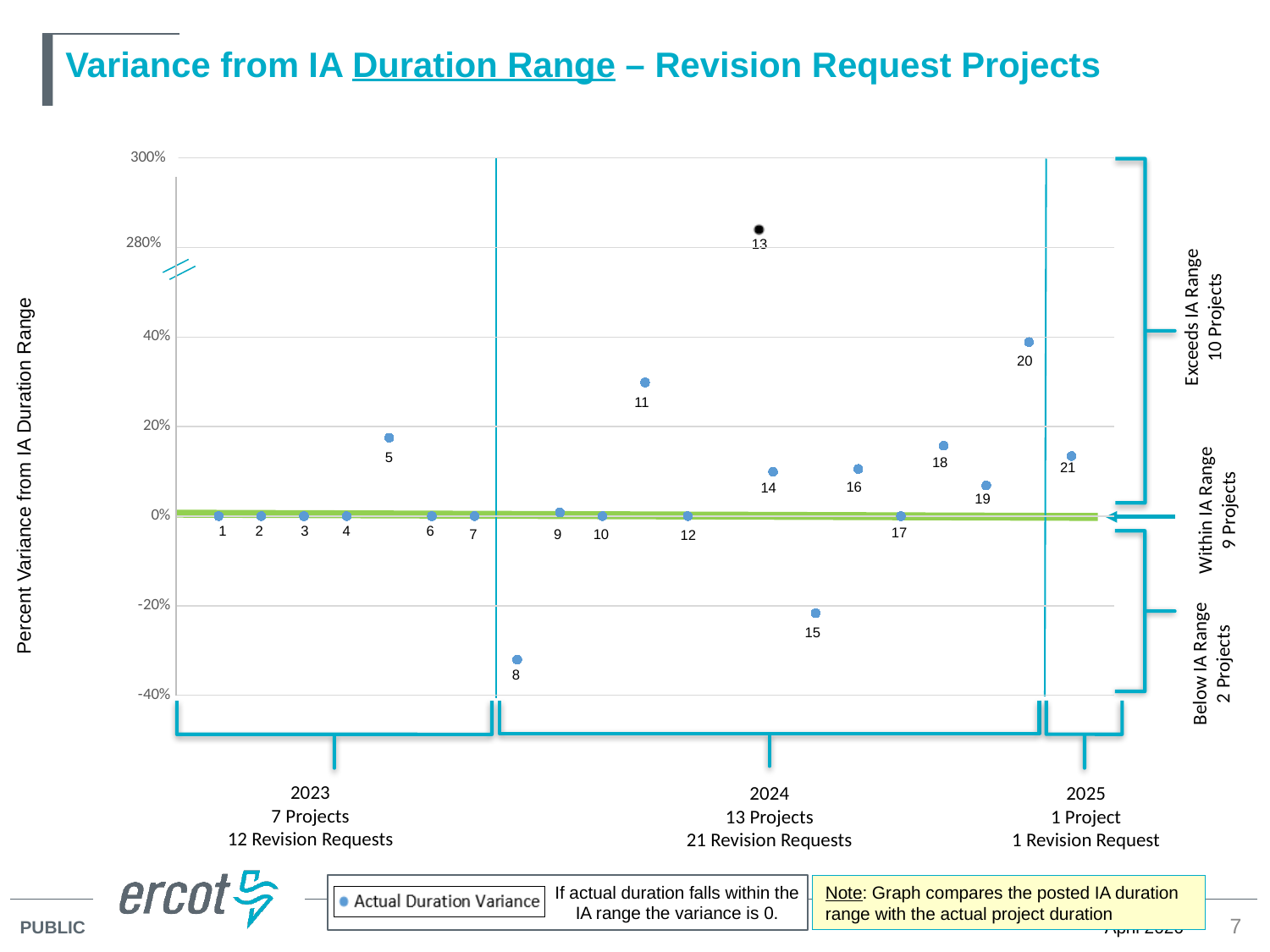
According to the annotation on the right of the chart, how many projects exceed the IA range? 10 Projects Is the value for project 8 greater or less than -20%? less Is the value for project 14 greater or less than 20%? less What is the percent variance for project 1? 0% How many data points are plotted on the chart? 21 How many series does the legend list? 1 Which has a higher percent variance, project 20 or project 11? Project 20 Which project number has the lowest percent variance from IA duration range? 8 Is the value for project 11 greater or less than 20%? greater What type of chart is shown on the slide? Scatter chart Which project number has the highest percent variance from IA duration range? 13